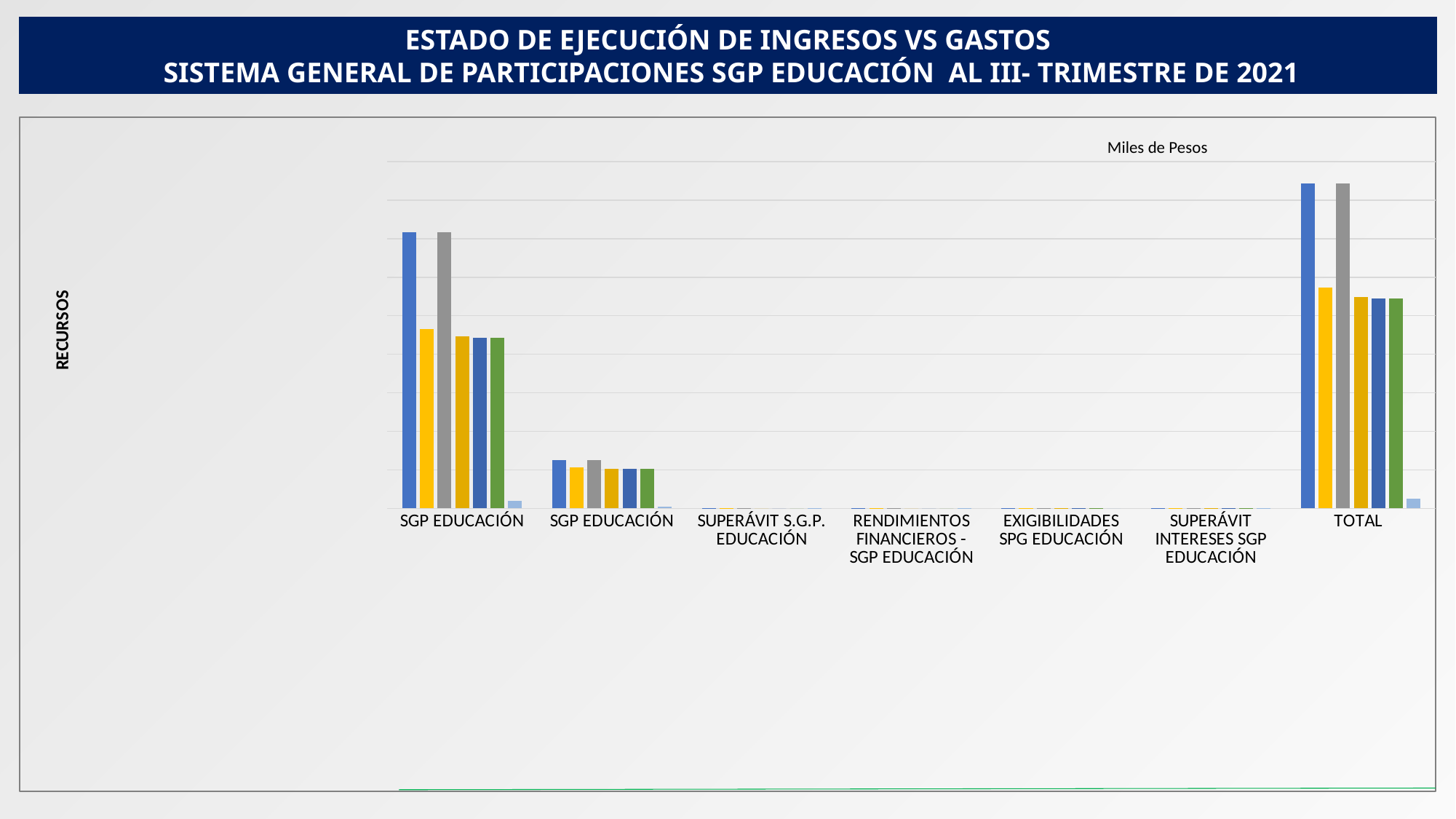
What unit is indicated in the top right of the chart area? Miles de Pesos Which category has the tallest bars in the chart? TOTAL How many bars are plotted for the TOTAL category? 7 How many categories are shown along the x axis of the chart? 7 Which category has taller bars: the first SGP EDUCACIÓN group or the second SGP EDUCACIÓN group? the first SGP EDUCACIÓN group Which category has taller bars: TOTAL or SUPERÁVIT S.G.P. EDUCACIÓN? TOTAL Which category has taller bars: RENDIMIENTOS FINANCIEROS - SGP EDUCACIÓN or the second SGP EDUCACIÓN group? SGP EDUCACIÓN What kind of chart is shown on the slide? bar chart What is the label on the vertical axis of the chart? RECURSOS